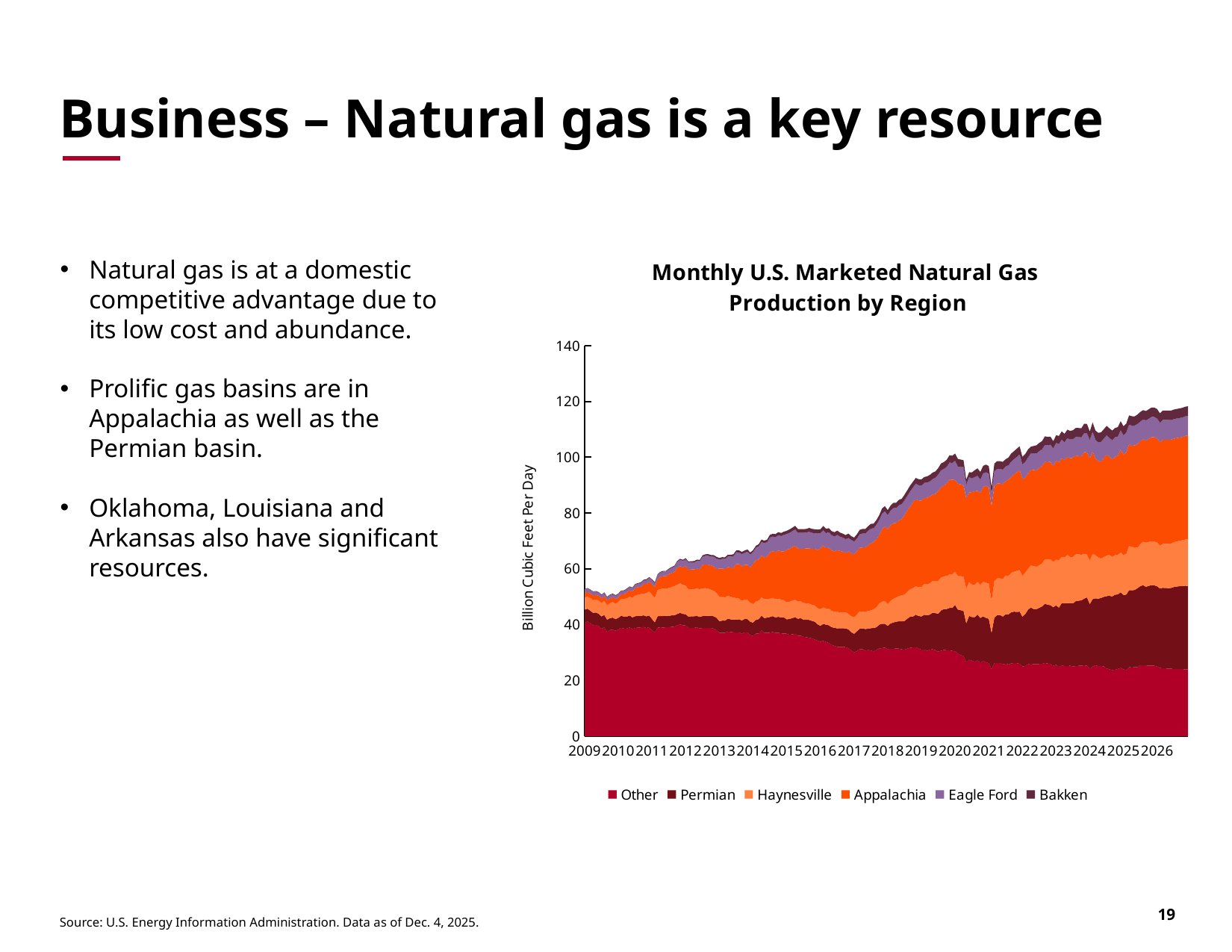
What is the highest value shown on the vertical axis? 140 How many series does the legend list? 6 Does total marketed natural gas production rise or fall from 2009 to 2026? Rise Is the total production at the start of 2009 greater or less than 60 billion cubic feet per day? less What kind of chart is shown on the slide? Stacked area chart Which region is the largest contributor to total production in 2026, Appalachia or Bakken? Appalachia Is the total production in 2026 greater or less than 100 billion cubic feet per day? greater Does the 'Other' region's production rise or fall from 2009 to 2026? Fall What is the title of the chart? Monthly U.S. Marketed Natural Gas Production by Region How many year labels are shown along the x axis? 18 What is the label on the vertical axis of the chart? Billion Cubic Feet Per Day